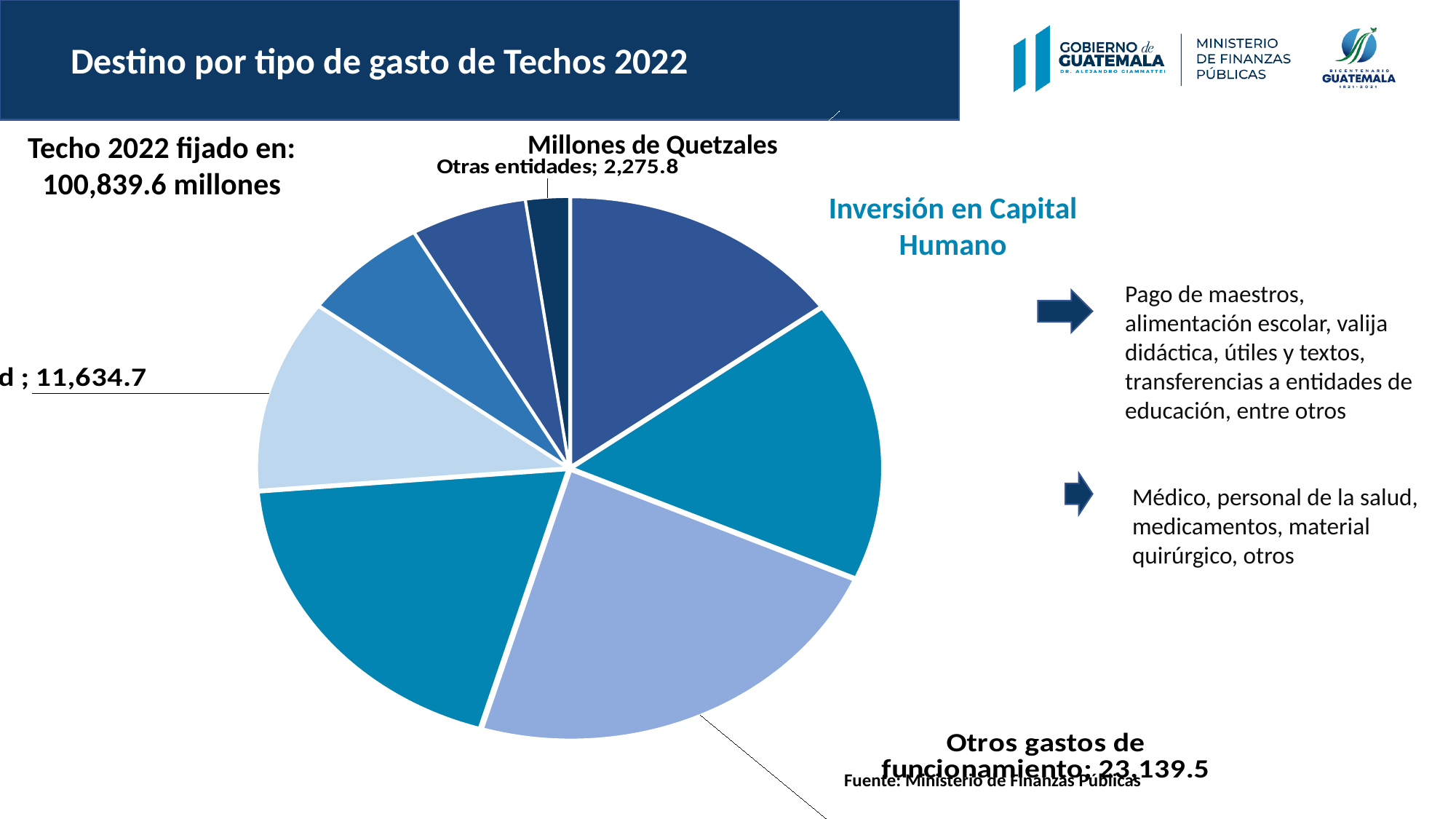
Which labelled slice is the smallest in the pie chart? Otras entidades What value is shown for the 'Otras entidades' slice? 2,275.8 What kind of chart is shown on the slide? Pie chart How many slices does the pie chart have? 8 What source is cited below the chart? Ministerio de Finanzas Públicas What is the difference between the 'Otros gastos de funcionamiento' value and the 'Otras entidades' value? 20,863.7 What value is shown for the 'Otros gastos de funcionamiento' slice? 23,139.5 Which is larger, 'Otros gastos de funcionamiento' or 'Otras entidades'? Otros gastos de funcionamiento What is the title of the pie chart? Millones de Quetzales